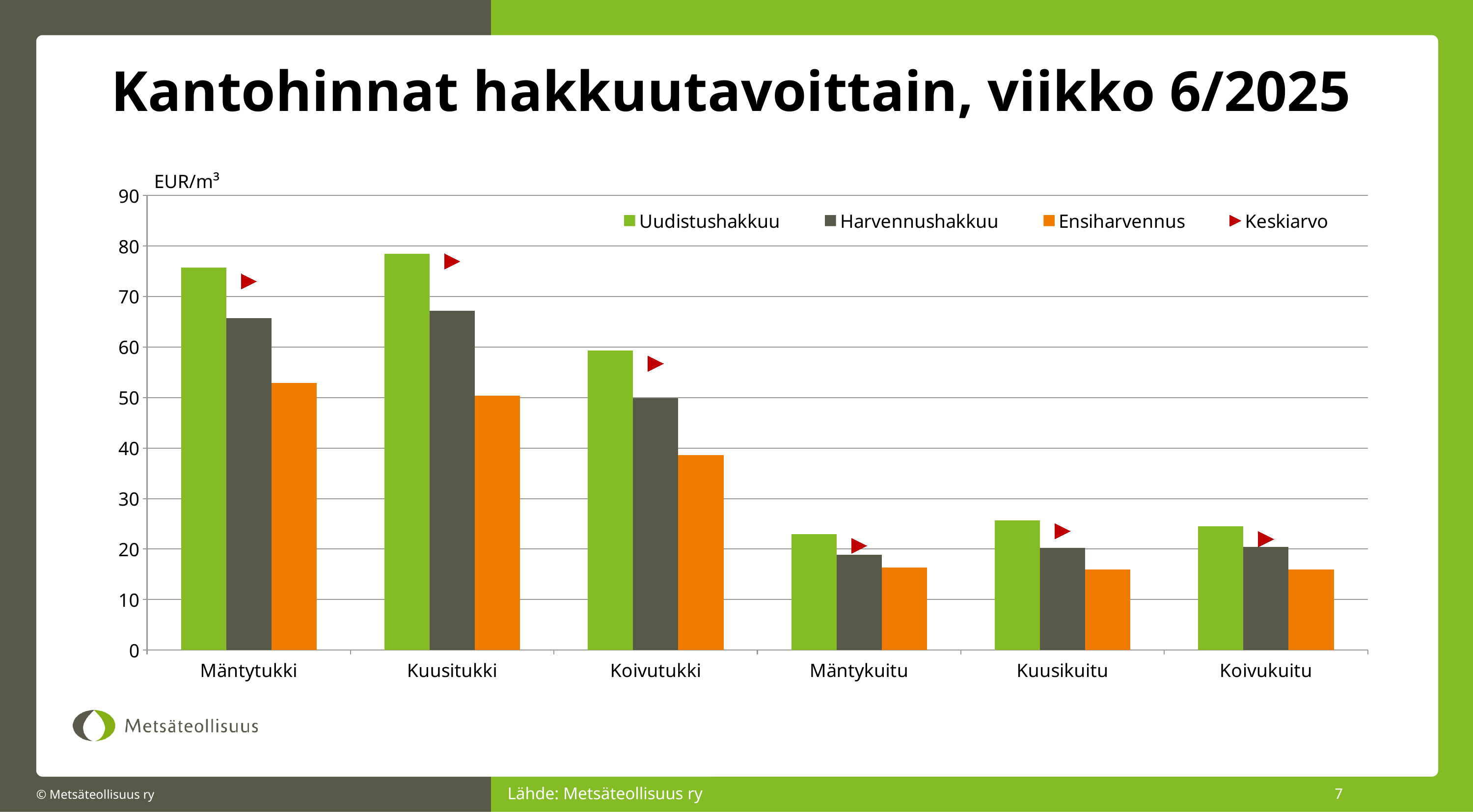
Is the Harvennushakkuu value for Kuusitukki greater or less than 60? greater How many series does the legend list? 4 Is the Uudistushakkuu value for Mäntytukki greater or less than 70? greater Among Mäntytukki, Kuusitukki and Koivutukki, which has the lowest Ensiharvennus value? Koivutukki Which category has the highest Uudistushakkuu value? Kuusitukki What unit is shown on the y axis? EUR/m³ Is the Uudistushakkuu value for Mäntykuitu greater or less than 30? less How many categories are shown on the x axis? 6 What kind of chart is shown on the slide? bar chart What colour are the Ensiharvennus bars? orange Which is larger, the Uudistushakkuu value for Kuusitukki or for Koivutukki? Kuusitukki